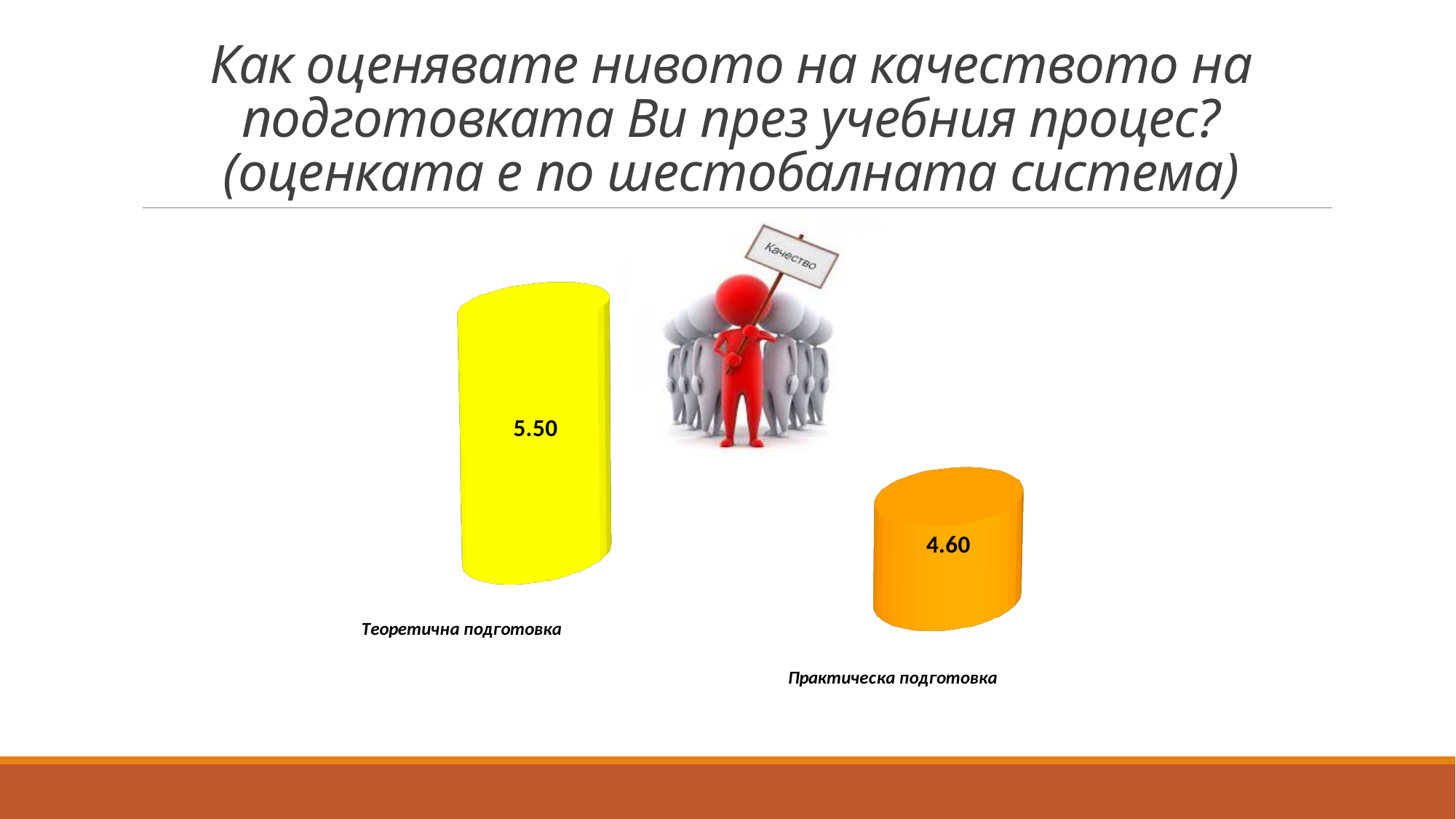
What colour is the bar for Теоретична подготовка? yellow Which is larger, the value for Теоретична подготовка or the value for Практическа подготовка? Теоретична подготовка What colour is the bar for Практическа подготовка? orange How many categories are shown in the chart? 2 Which category has the lowest value? Практическа подготовка What is the value for Теоретична подготовка? 5.50 What is the value for Практическа подготовка? 4.60 What kind of chart is shown on the slide? bar chart Which category has the highest value? Теоретична подготовка What is the difference between the values for Теоретична подготовка and Практическа подготовка? 0.90